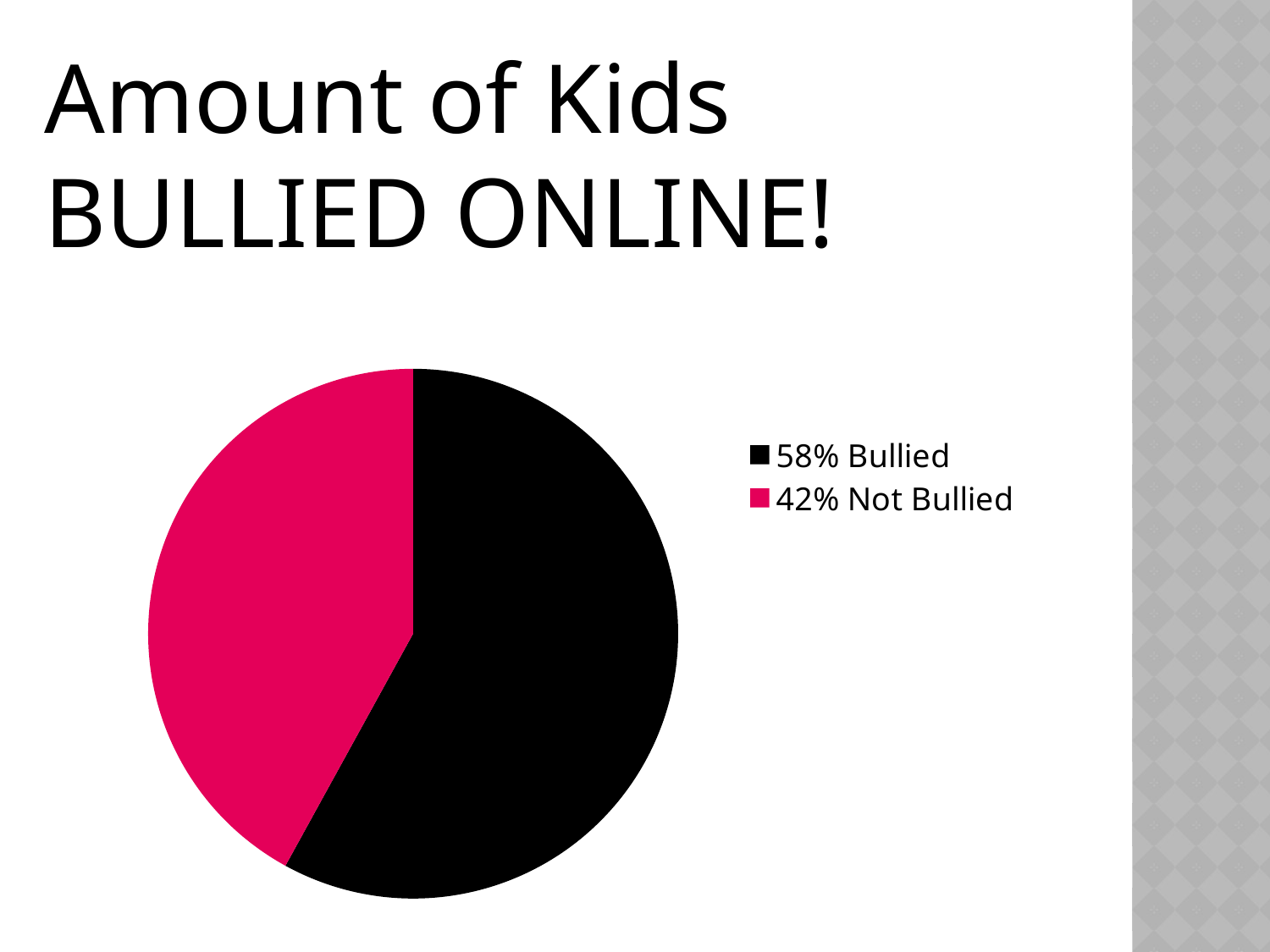
What share of the pie is labelled Bullied? 58% Which is larger, the Bullied slice or the Not Bullied slice? Bullied What kind of chart is shown on the slide? pie chart How many slices does the pie chart have? 2 Which slice is the largest? 58% Bullied Which slice is the smallest? 42% Not Bullied What is the title of the slide containing the chart? Amount of Kids BULLIED ONLINE! How many entries does the legend list? 2 What is the difference in percentage points between the Bullied and Not Bullied slices? 16 What colour is the Bullied slice? black What share of the pie is labelled Not Bullied? 42%